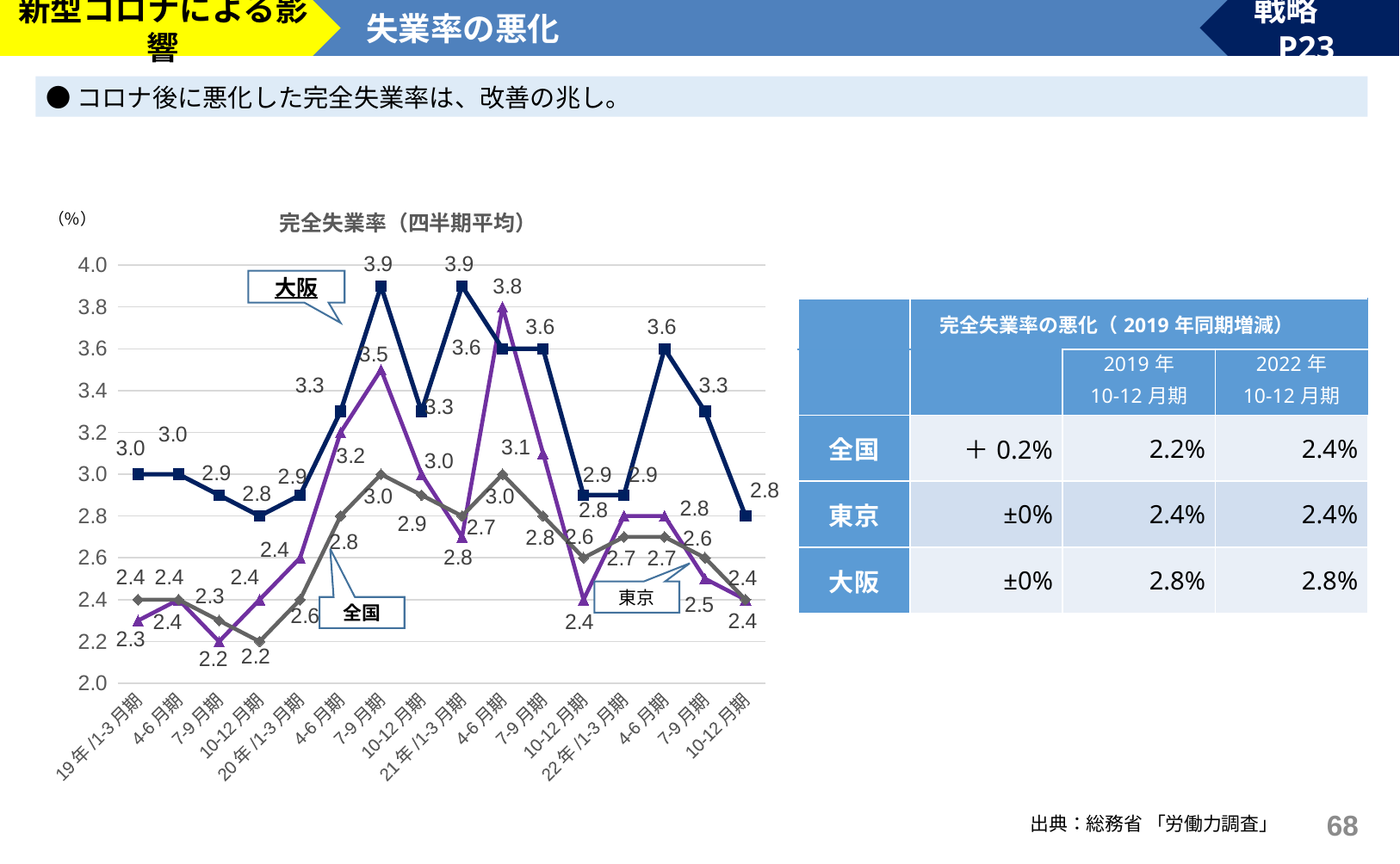
How many quarters (x-axis points) are plotted in the chart? 16 In which quarter does 東京 reach its highest value? 21年/4-6月期 Which is larger in 21年/4-6月期, the value for 東京 or the value for 大阪? 東京 What is the value for 全国 in 22年/10-12月期? 2.4 In which quarter does 全国 reach its lowest value? 19年/10-12月期 Does the value for 大阪 rise or fall from 22年/4-6月期 to 22年/10-12月期? fall What kind of chart is shown on the slide? line chart What is the title of the chart? 完全失業率（四半期平均） What is the value for 東京 in 21年/4-6月期? 3.8 What is the value for 大阪 in 20年/7-9月期? 3.9 How many series are plotted in the chart 完全失業率（四半期平均）? 3 What is the difference between 大阪 and 全国 in 22年/4-6月期? 0.9